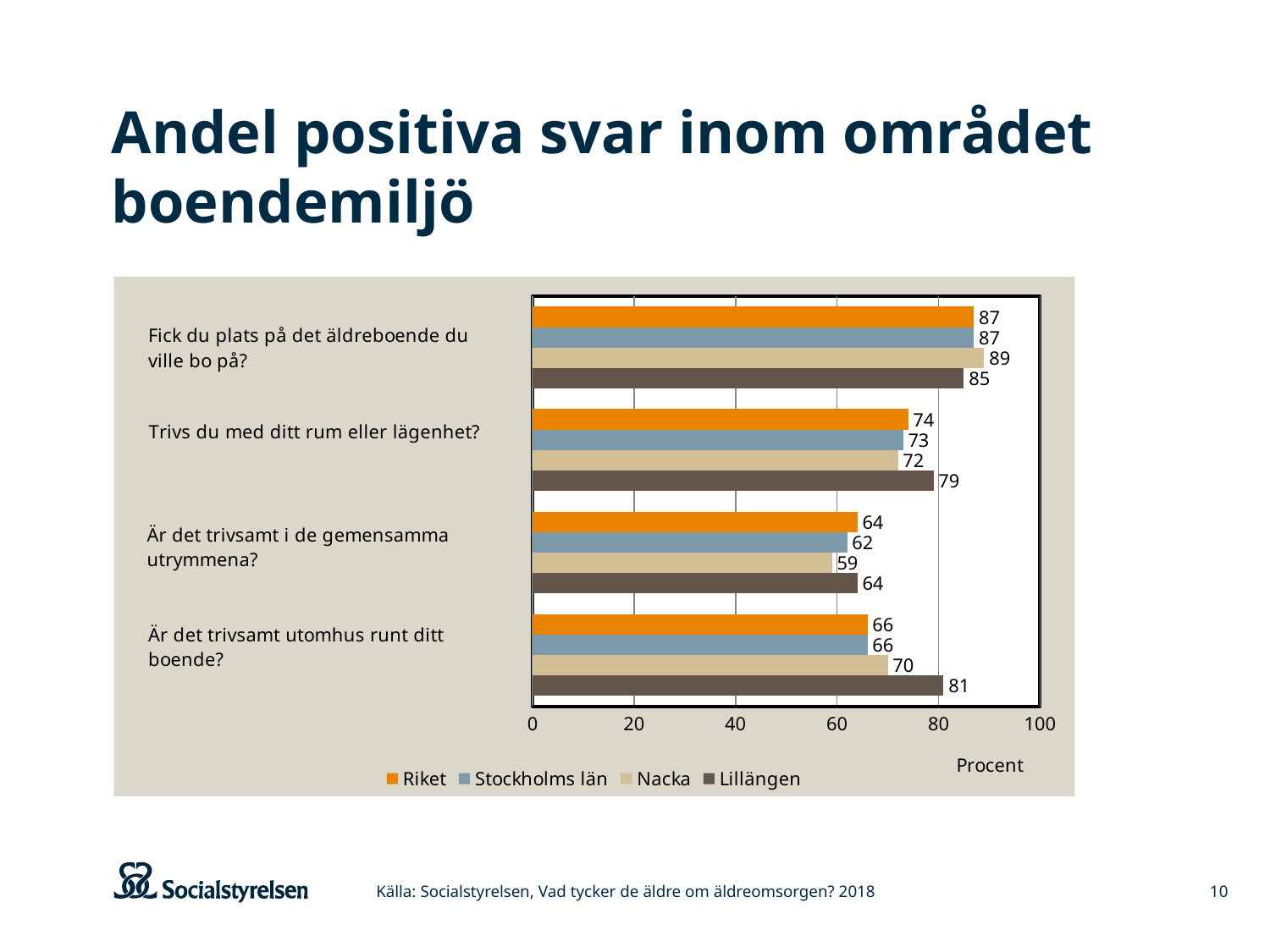
How many series does the legend list? 4 Which series has the highest value on "Trivs du med ditt rum eller lägenhet?"? Lillängen What is the value for Lillängen on "Är det trivsamt utomhus runt ditt boende?"? 81 What is the value for Stockholms län on "Trivs du med ditt rum eller lägenhet?"? 73 Which is larger on "Fick du plats på det äldreboende du ville bo på?": Nacka or Lillängen? Nacka What kind of chart is shown on the slide? Bar chart What is the value for Nacka on "Fick du plats på det äldreboende du ville bo på?"? 89 How many question categories are shown on the chart? 4 What is the difference between Lillängen and Riket on "Är det trivsamt utomhus runt ditt boende?"? 15 Which series has the lowest value on "Är det trivsamt i de gemensamma utrymmena?"? Nacka What is the label on the horizontal axis of the chart? Procent What is the value for Riket on "Är det trivsamt i de gemensamma utrymmena?"? 64